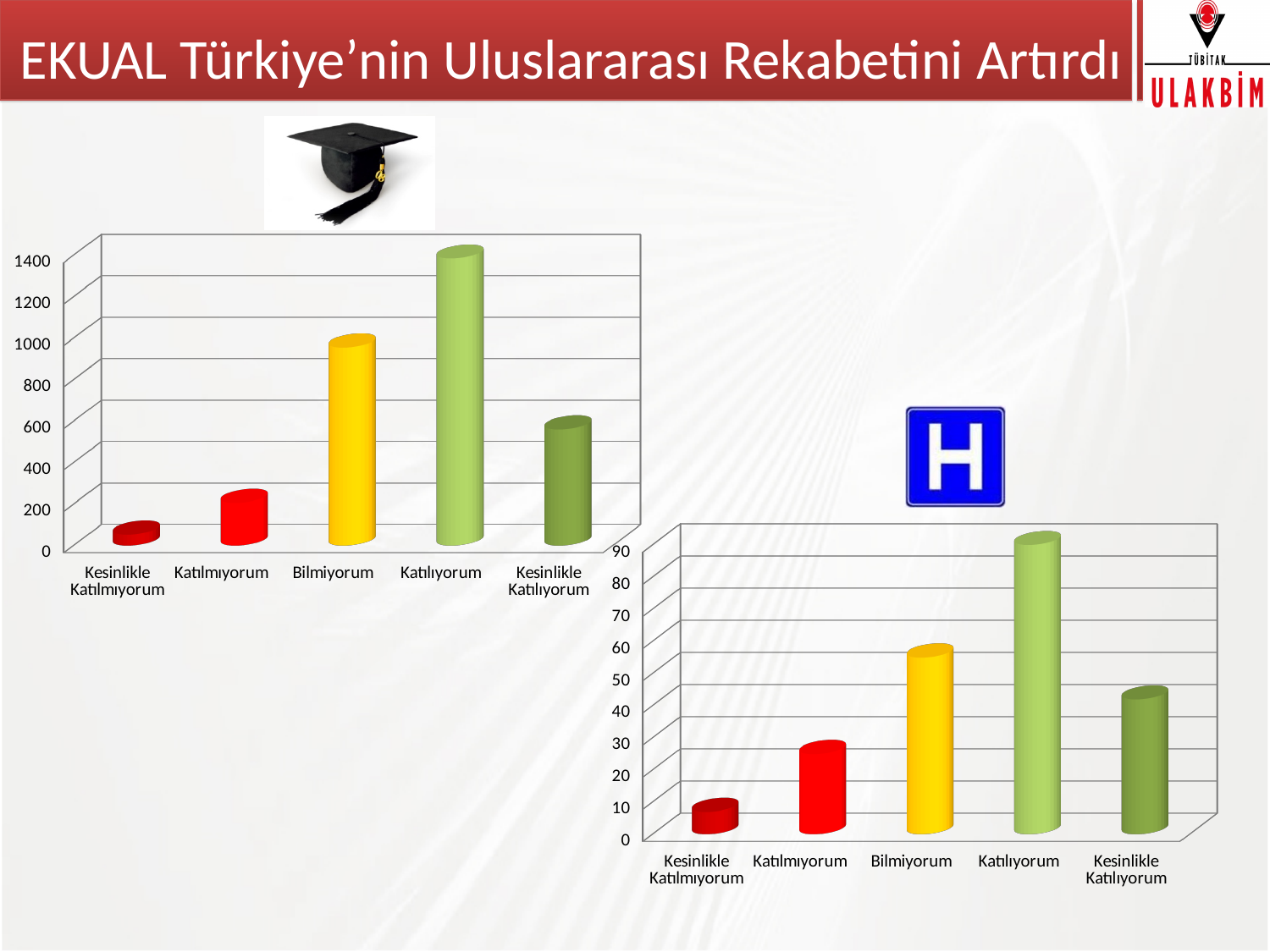
On the top-left chart (axis up to 1400), which is larger, Bilmiyorum or Kesinlikle Katılıyorum? Bilmiyorum On the bottom-right chart (axis up to 90), is the value for Bilmiyorum greater or less than 50? greater What kind of chart is the bottom-right chart (axis up to 90)? bar chart On the bottom-right chart (axis up to 90), which category has the highest bar? Katılıyorum On the top-left chart (axis up to 1400), is the value for Bilmiyorum greater or less than 800? greater On the top-left chart (axis up to 1400), how many categories are shown on the x axis? 5 On the top-left chart (axis up to 1400), is the value for Katılmıyorum greater or less than 400? less On the top-left chart (axis up to 1400), which category has the lowest bar? Kesinlikle Katılmıyorum On the top-left chart (axis up to 1400), which category has the highest bar? Katılıyorum On the bottom-right chart (axis up to 90), which is larger, Katılmıyorum or Kesinlikle Katılıyorum? Kesinlikle Katılıyorum On the bottom-right chart (axis up to 90), which category has the lowest bar? Kesinlikle Katılmıyorum